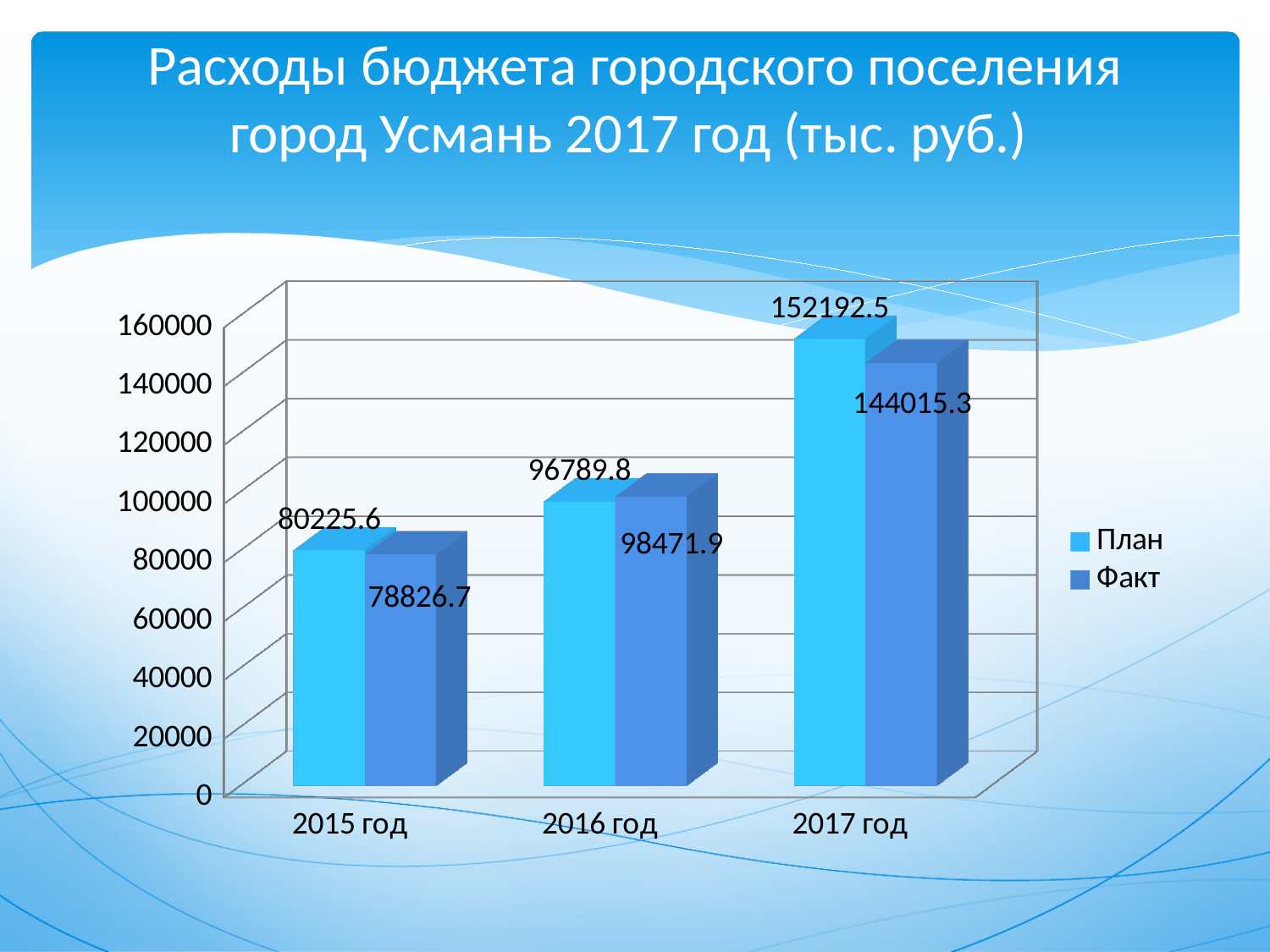
How many series does the legend list? 2 What is the difference between the План and Факт values for 2017 год? 8177.2 What is the Факт value for 2015 год? 78826.7 What is the План value for 2017 год? 152192.5 Is the Факт value for 2017 год greater or less than 140000? greater Which year has the highest План value? 2017 год For 2016 год, which is larger, План or Факт? Факт What kind of chart is shown on the slide? bar chart Which year has the lowest Факт value? 2015 год What is the Факт value for 2016 год? 98471.9 How many years are shown on the x axis? 3 What is the difference between the Факт and План values for 2016 год? 1682.1